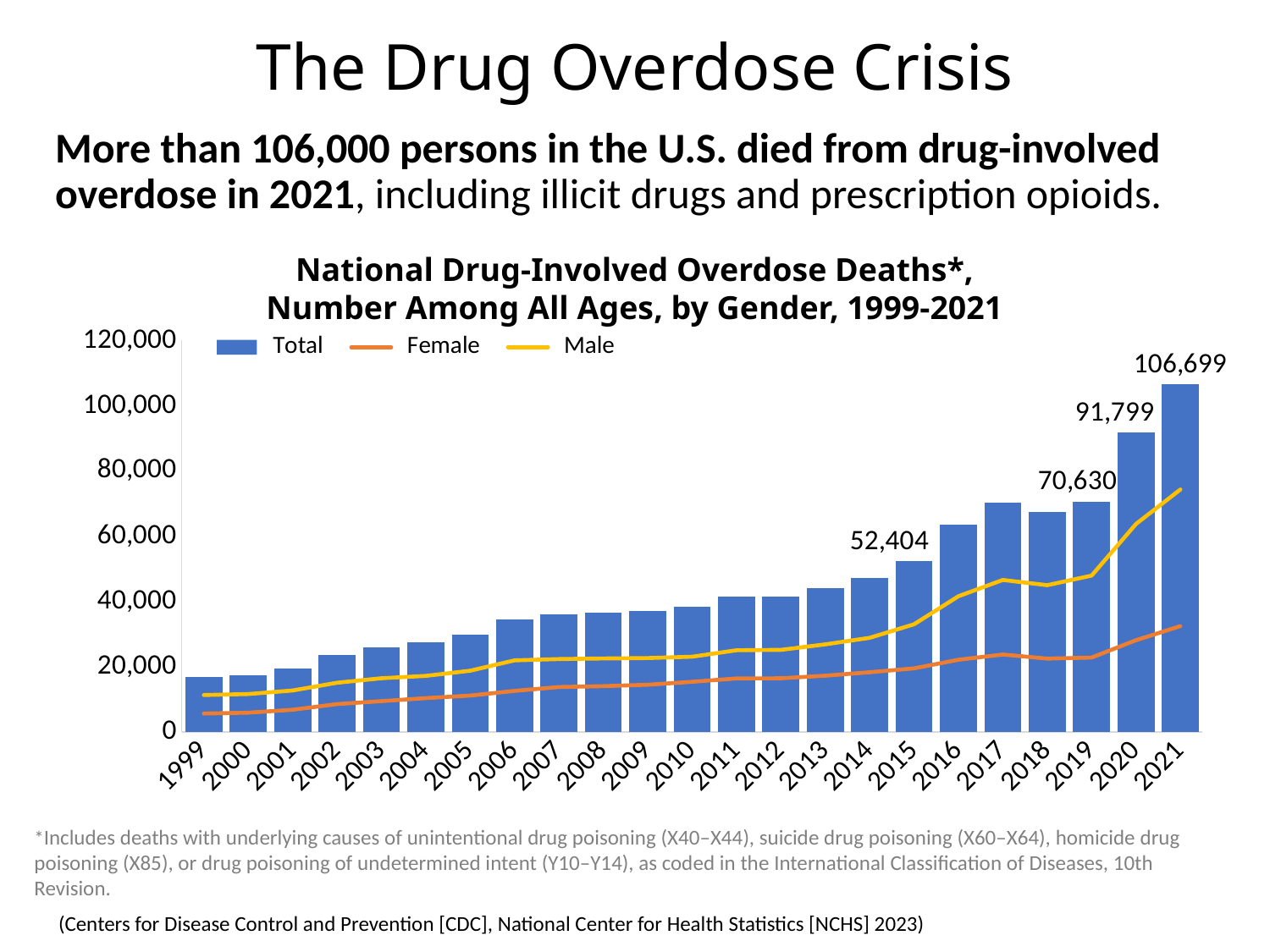
What is the total number of overdose deaths labeled for 2020? 91,799 In 2021, which line is higher, Male or Female? Male Which year has the highest total number of overdose deaths? 2021 What is the total number of overdose deaths labeled for 2015? 52,404 What is the difference between the total overdose deaths in 2021 and 2020? 14,900 Is the total number of overdose deaths for 1999 greater or less than 20,000? less Is the Male value for 2021 greater or less than 60,000? greater How many series does the chart legend list? 3 How many years are shown on the x axis of the chart? 23 What is the total number of drug-involved overdose deaths shown for 2021? 106,699